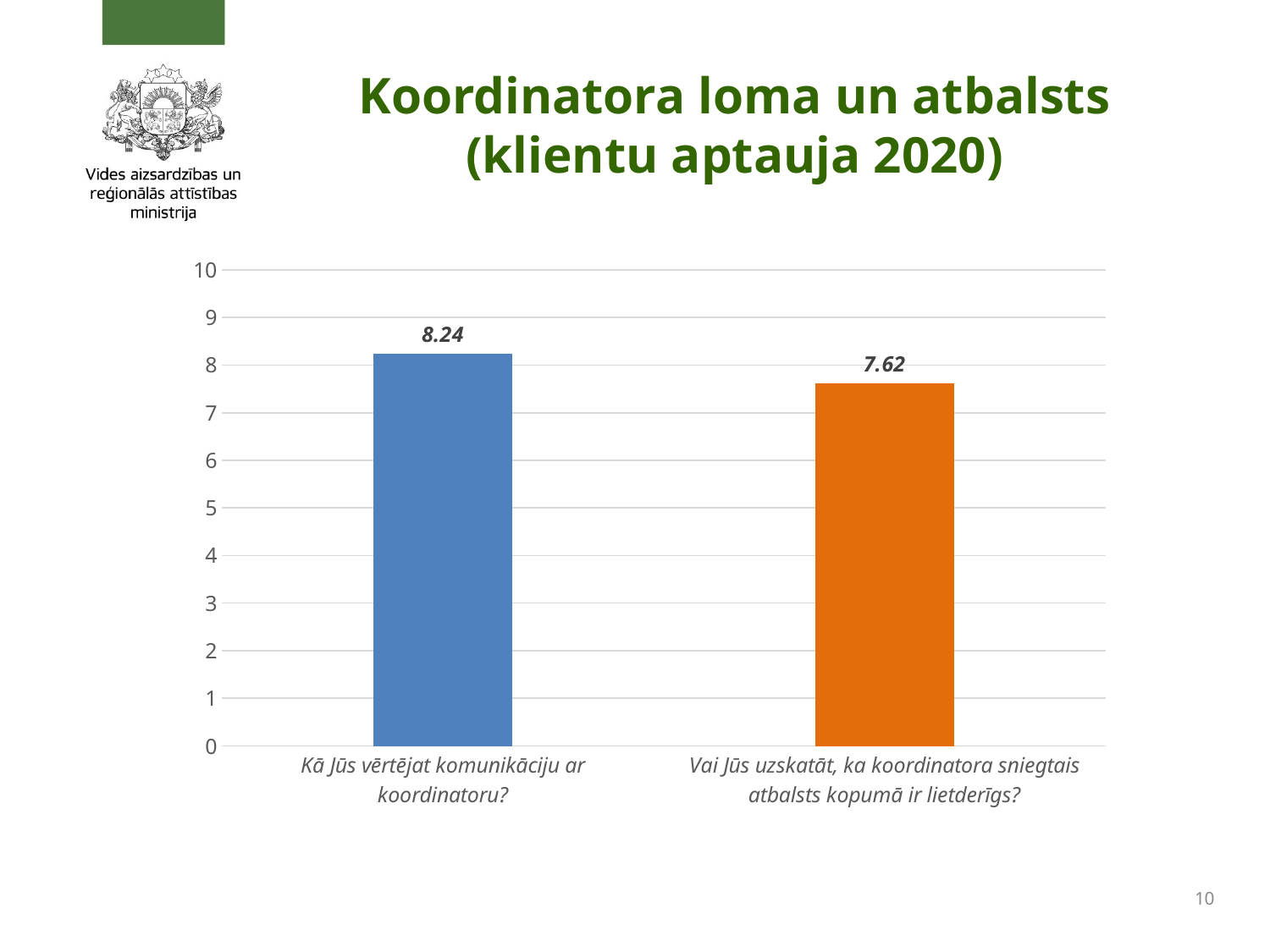
What colour is the bar for "Vai Jūs uzskatāt, ka koordinatora sniegtais atbalsts kopumā ir lietderīgs?"? orange What kind of chart is shown on the slide? bar chart What is the value for "Kā Jūs vērtējat komunikāciju ar koordinatoru?"? 8.24 How many categories are shown in the chart? 2 Which is larger: the value for "Kā Jūs vērtējat komunikāciju ar koordinatoru?" or the value for "Vai Jūs uzskatāt, ka koordinatora sniegtais atbalsts kopumā ir lietderīgs?"? Kā Jūs vērtējat komunikāciju ar koordinatoru? What is the maximum value shown on the vertical axis? 10 What is the value for "Vai Jūs uzskatāt, ka koordinatora sniegtais atbalsts kopumā ir lietderīgs?"? 7.62 What is the difference between the values for "Kā Jūs vērtējat komunikāciju ar koordinatoru?" and "Vai Jūs uzskatāt, ka koordinatora sniegtais atbalsts kopumā ir lietderīgs?"? 0.62 Is the value for "Vai Jūs uzskatāt, ka koordinatora sniegtais atbalsts kopumā ir lietderīgs?" greater or less than 8? less Is the value for "Kā Jūs vērtējat komunikāciju ar koordinatoru?" greater or less than 8? greater Which category has the lowest value? Vai Jūs uzskatāt, ka koordinatora sniegtais atbalsts kopumā ir lietderīgs? Which category has the highest value? Kā Jūs vērtējat komunikāciju ar koordinatoru?